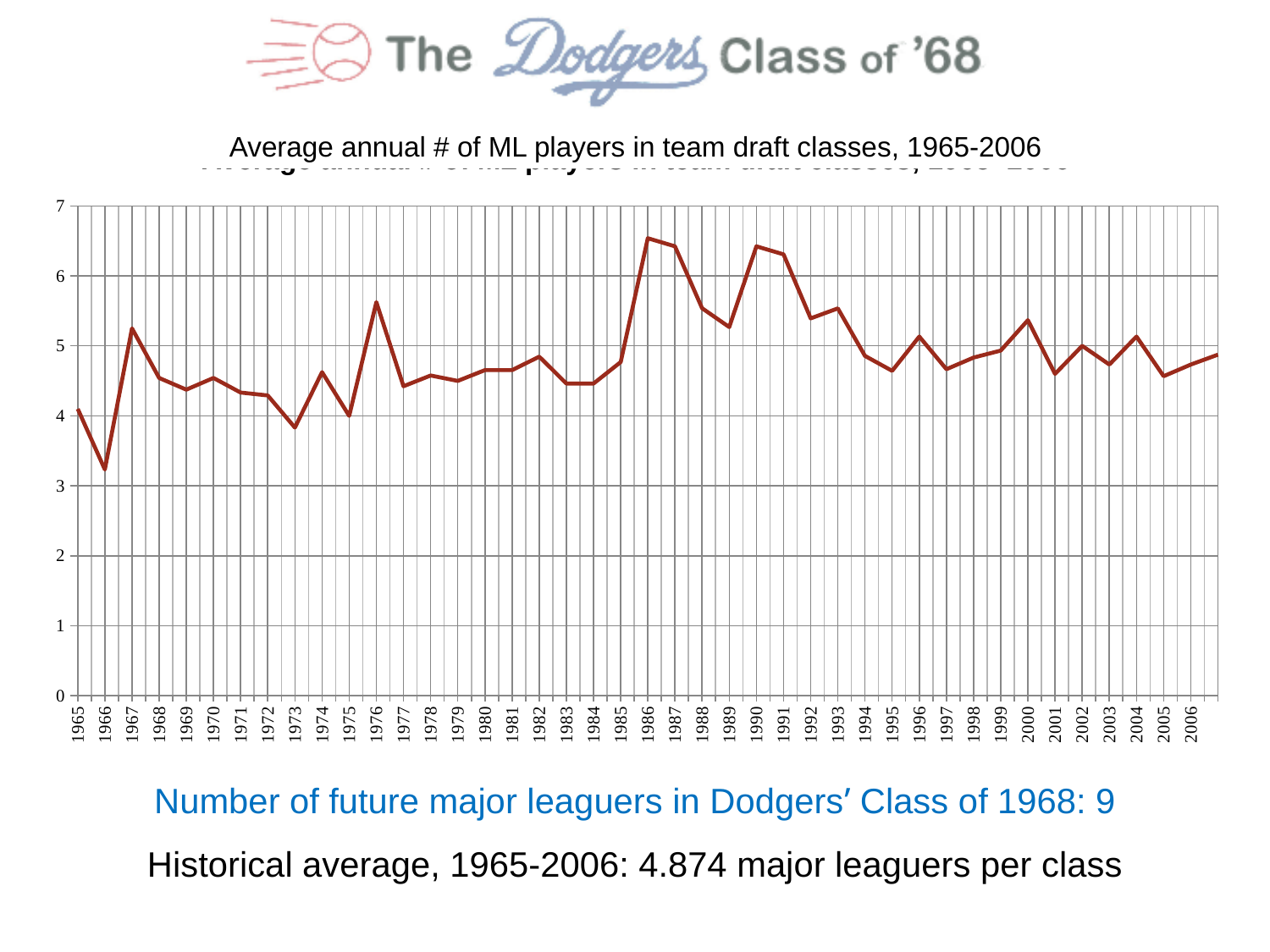
Is the value for 1976 greater or less than 5? greater What kind of chart is shown on the slide? line chart Which year has the larger value, 1990 or 1995? 1990 Which year has the lowest value on the chart? 1966 What is the highest tick value shown on the y axis? 7 Is the value for 1966 greater or less than 4? less What is the title of the chart? Average annual # of ML players in team draft classes, 1965-2006 Is the value for 1986 greater or less than 6? greater Do the values rise or fall from 1986 to 1989? fall Which year has the highest value on the chart? 1986 How many years (data points) are plotted along the x axis? 42